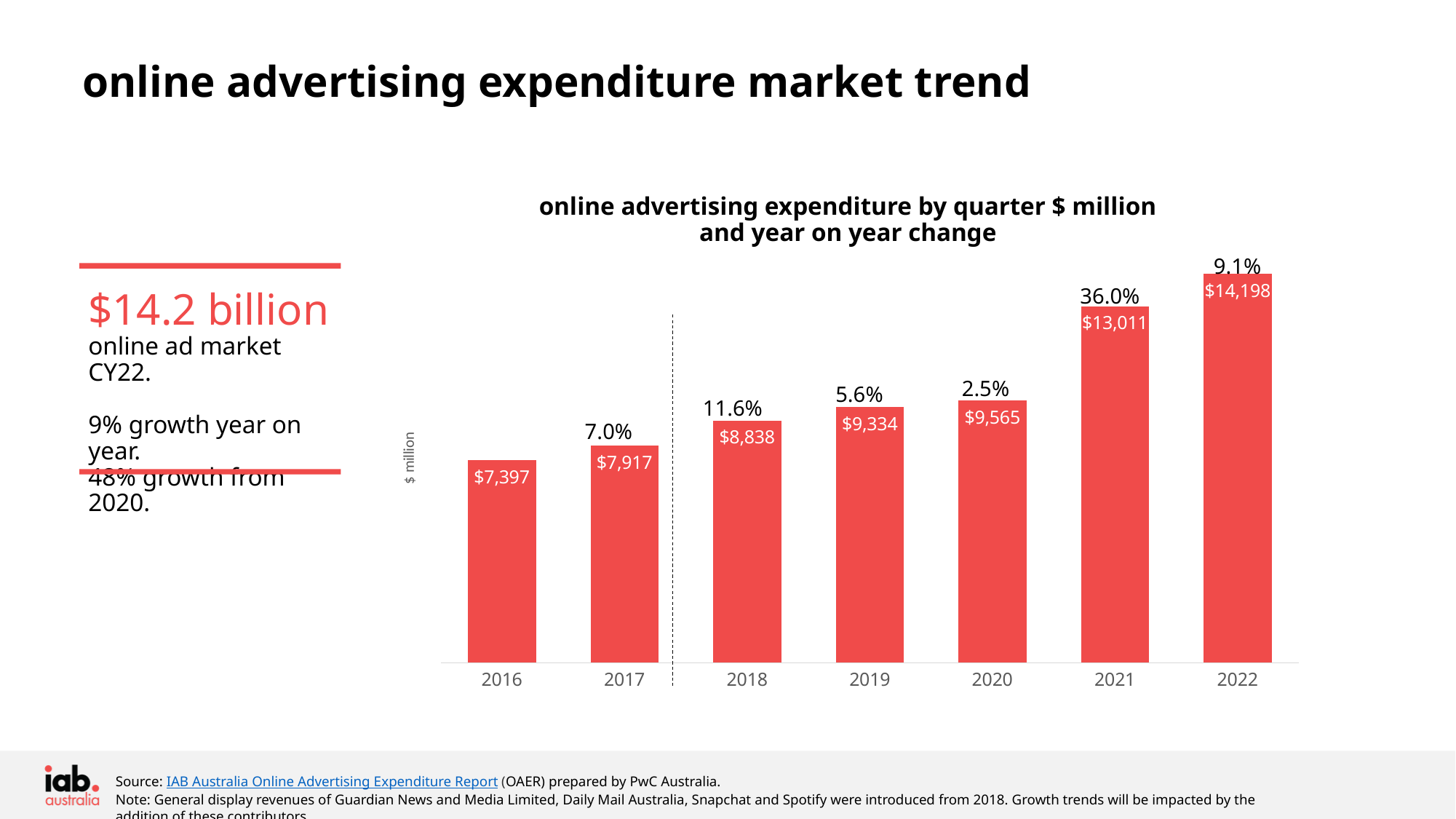
How many years are shown on the x axis of the chart? 7 Which is larger, the expenditure for 2018 or for 2020? 2020 What is the title of the chart? online advertising expenditure by quarter $ million and year on year change What is the online advertising expenditure value shown for 2022? $14,198 Do the expenditure values rise or fall from 2016 to 2022? Rise What kind of chart is shown on the slide? Bar chart Which year has the highest online advertising expenditure? 2022 What is the difference between the expenditure values for 2022 and 2021? $1,187 What year on year change is shown above the 2019 bar? 5.6% Which year has the lowest online advertising expenditure? 2016 What is the online advertising expenditure value shown for 2016? $7,397 What year on year change is shown above the 2021 bar? 36.0%